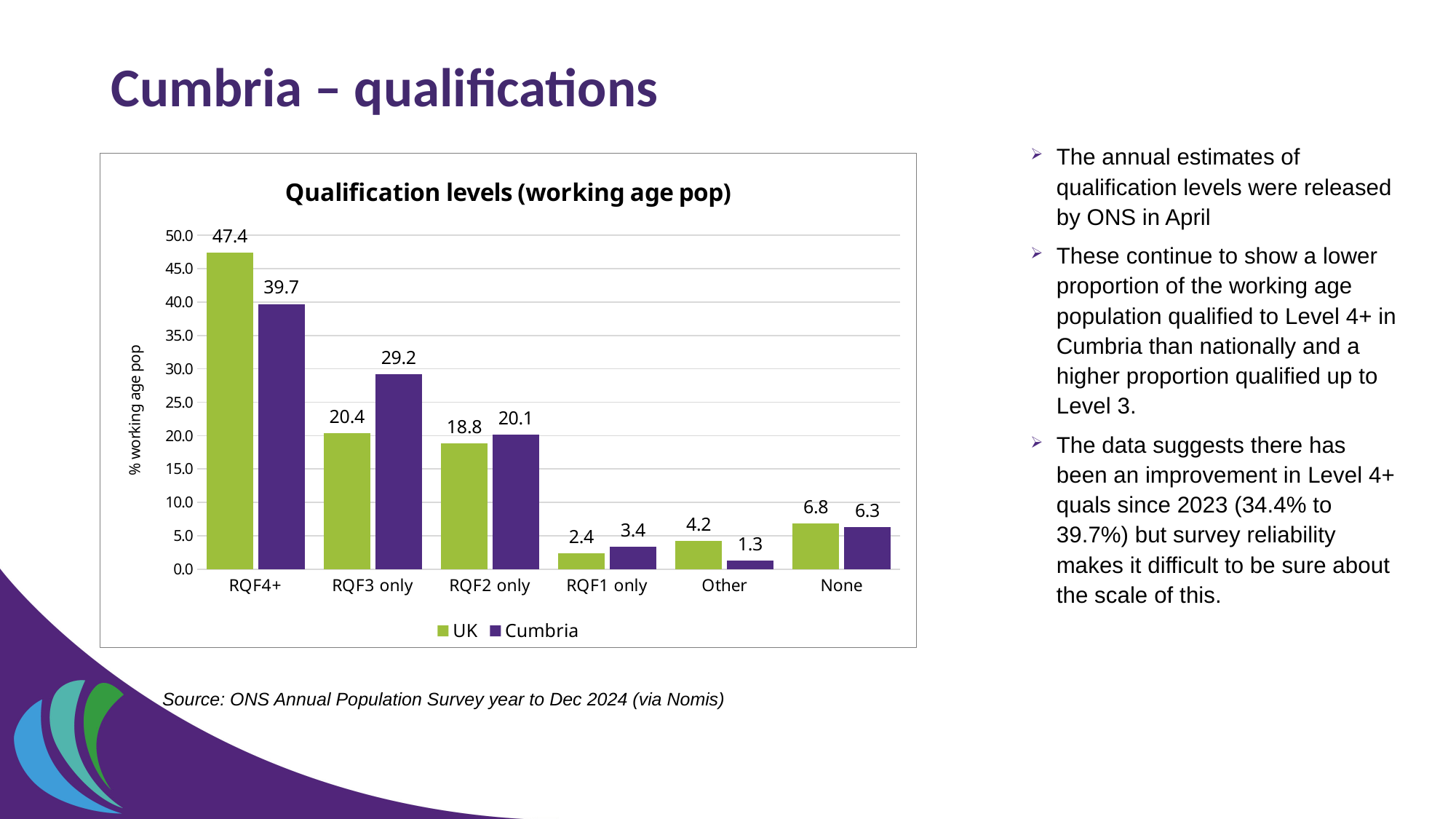
What is the Cumbria value for RQF3 only? 29.2 What is the Cumbria value for Other? 1.3 Which category has the lowest UK value? RQF1 only What is the UK value for RQF4+? 47.4 What is the difference between the UK and Cumbria values for RQF4+? 7.7 How many series does the legend list? 2 What kind of chart is shown? Bar chart Is the Cumbria value for RQF4+ greater or less than 35.0? greater Which is larger for RQF3 only, the UK value or the Cumbria value? Cumbria What is the title of the chart? Qualification levels (working age pop) Which category has the highest Cumbria value? RQF4+ How many categories are shown on the x axis? 6